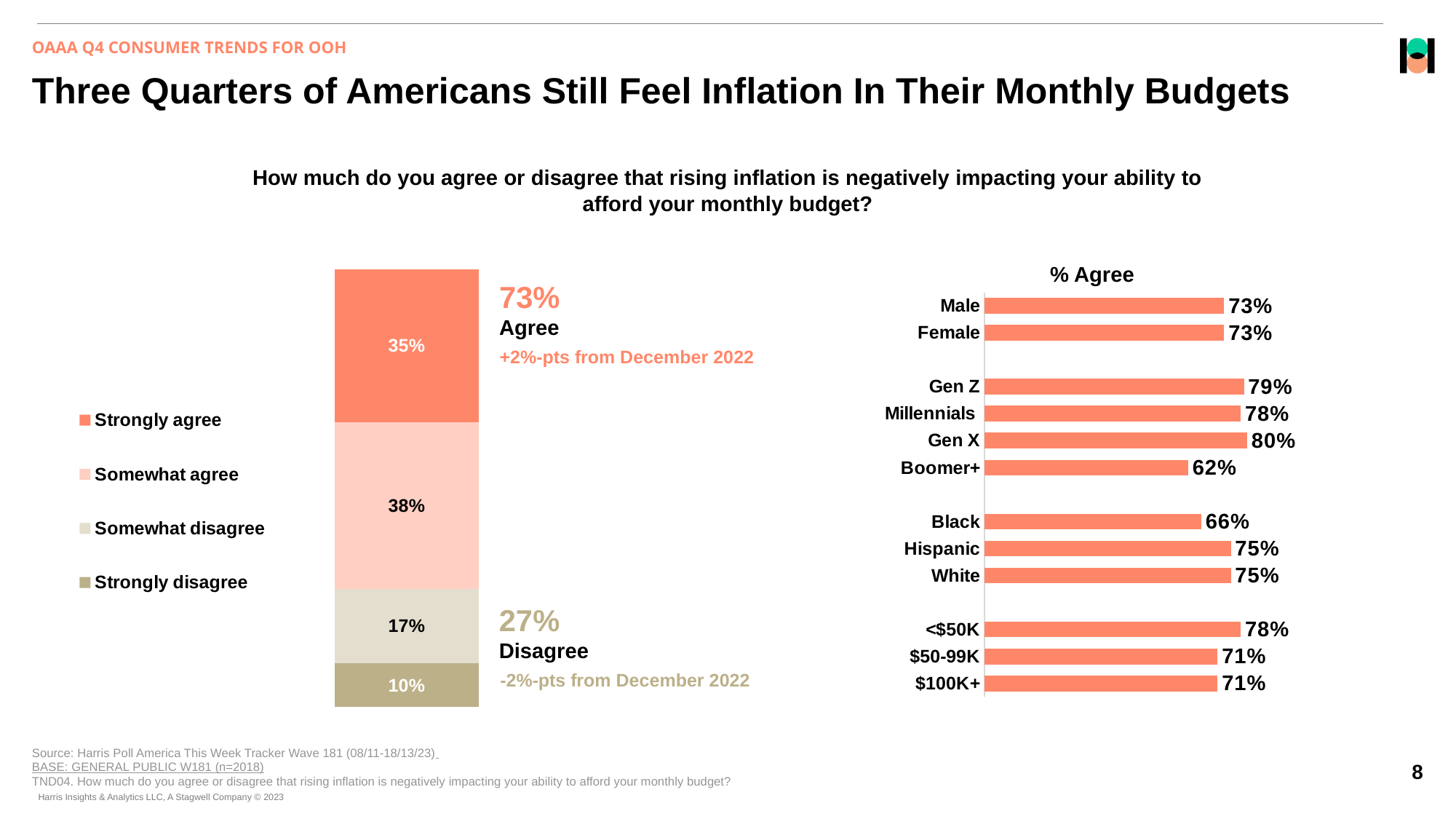
In the '% Agree' chart on the right, what is the value for Boomer+? 62% In the '% Agree' chart on the right, which is larger, the value for <$50K or the value for $100K+? <$50K In the stacked bar chart on the left, how many response categories does the legend list? 4 In the '% Agree' chart on the right, which group has the lowest value? Boomer+ In the '% Agree' chart on the right, what is the difference between Gen Z and Black? 13% In the stacked bar chart on the left, what percentage of respondents strongly agree? 35% What kind of chart is the '% Agree' chart on the right? Bar chart In the '% Agree' chart on the right, which group has the highest value? Gen X In the '% Agree' chart on the right, what is the value for Hispanic? 75% In the stacked bar chart on the left, which response category has the smallest share? Strongly disagree In the stacked bar chart on the left, what percentage of respondents somewhat disagree? 17% In the stacked bar chart on the left, what is the combined share of Strongly agree and Somewhat agree? 73%